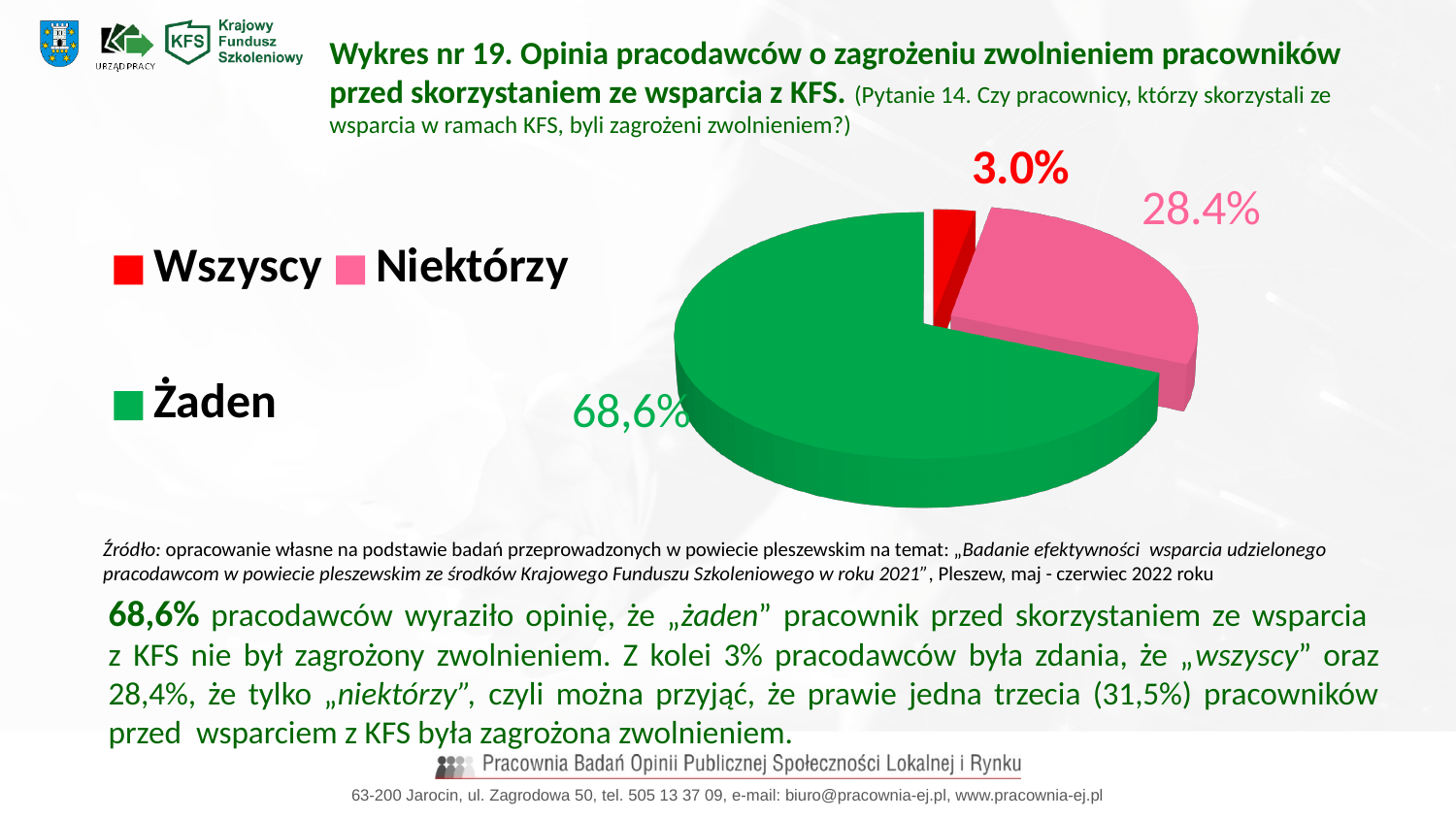
What value is shown for the "Niektórzy" slice? 28.4% Which slice is larger, "Niektórzy" or "Wszyscy"? Niektórzy What kind of chart is shown on the slide? Pie chart What colour is the "Żaden" slice in the pie chart? Green Which category has the smallest slice of the pie? Wszyscy What value is shown for the "Wszyscy" slice? 3.0% Which category has the largest slice of the pie? Żaden What share of the pie does the "Żaden" slice represent? 68,6% How many categories does the pie chart show? 3 Is the share for "Żaden" greater or less than 50%? greater What colour is the "Niektórzy" slice in the pie chart? Pink